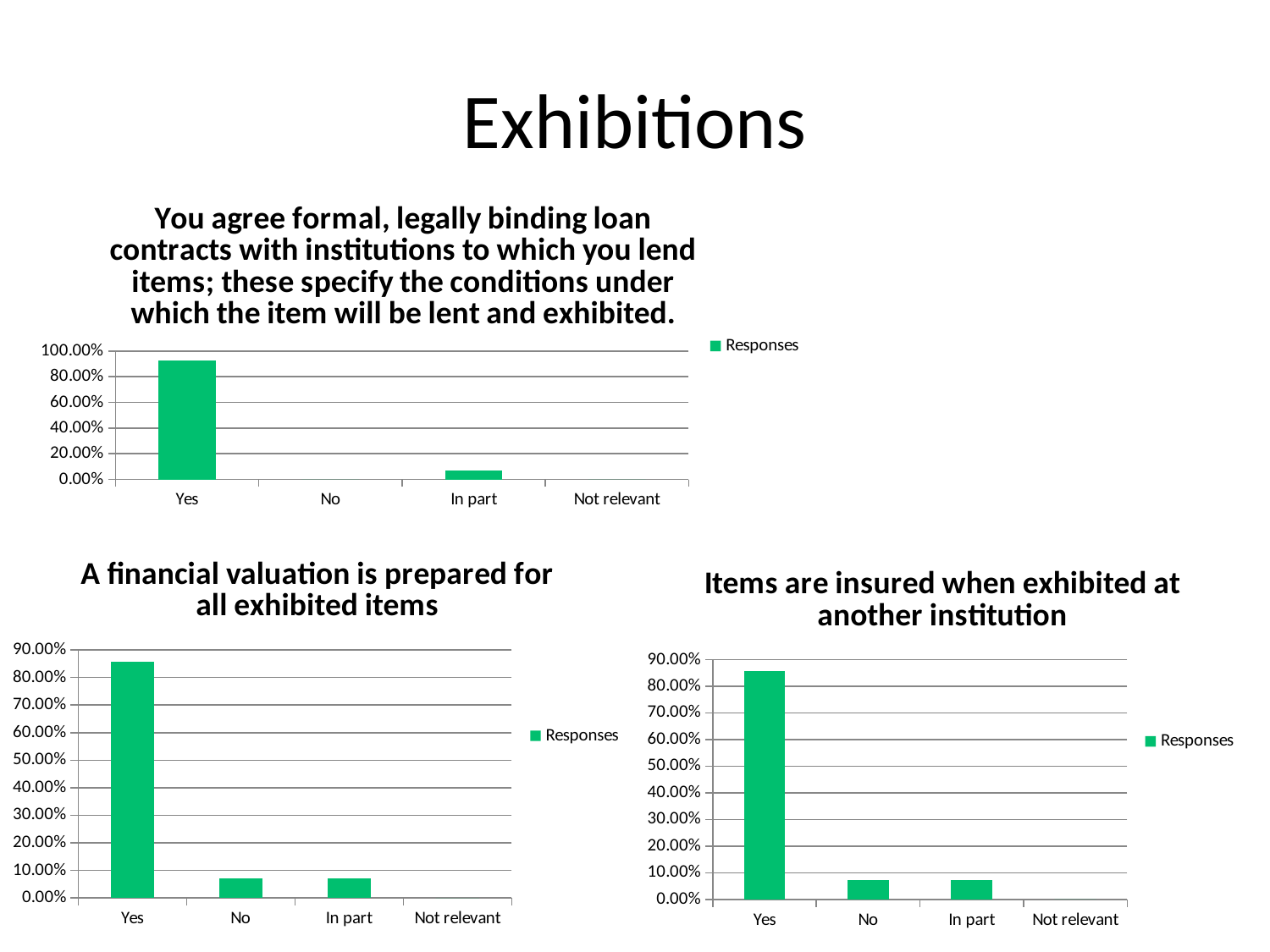
What is the highest value shown on the y axis of the top chart about formal, legally binding loan contracts? 100.00% What kind of chart is the chart titled 'Items are insured when exhibited at another institution'? bar chart How many series does the legend list in the top chart about formal, legally binding loan contracts? 1 How many categories are shown on the x axis of the chart titled 'A financial valuation is prepared for all exhibited items'? 4 In the top chart about formal, legally binding loan contracts, is the value for In part greater or less than 20.00%? less What is the name of the series shown in the legend of the chart titled 'A financial valuation is prepared for all exhibited items'? Responses In the chart titled 'Items are insured when exhibited at another institution', is the value for No greater or less than 10.00%? less In the chart titled 'A financial valuation is prepared for all exhibited items', which category has the highest value? Yes In the chart titled 'A financial valuation is prepared for all exhibited items', is the value for Yes greater or less than 80.00%? greater In the chart titled 'Items are insured when exhibited at another institution', which is larger, the value for Yes or the value for In part? Yes In the chart titled 'Items are insured when exhibited at another institution', which category has the lowest value? Not relevant